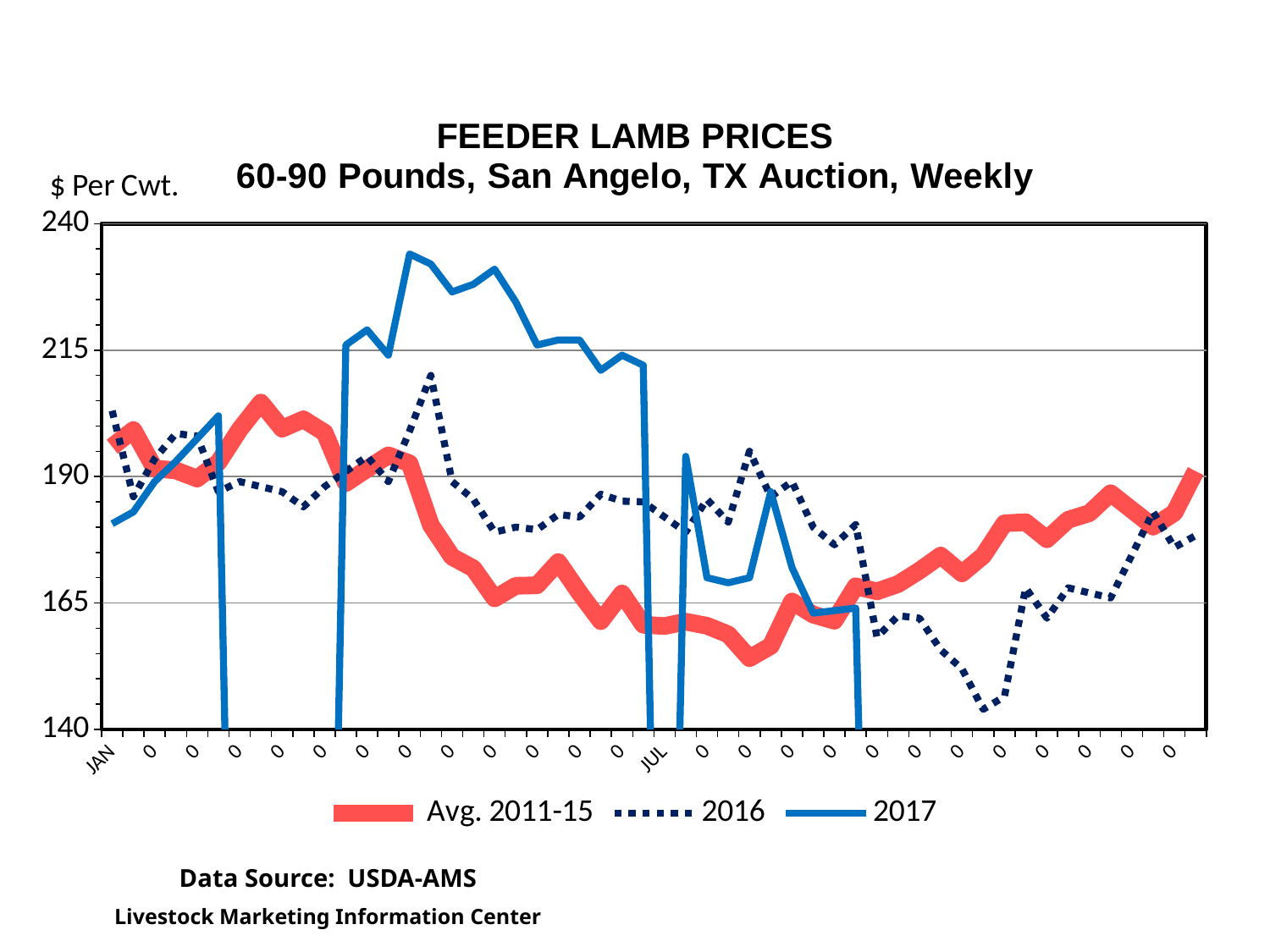
Is the highest value reached by the 2017 line greater or less than 215? greater How many series does the legend list? 3 At JUL, which is higher, the 2016 line or the Avg. 2011-15 line? 2016 Is the value of the Avg. 2011-15 line at JUL greater or less than 165? less Is the value of the Avg. 2011-15 line at JAN greater or less than 190? greater What unit is shown on the y axis of the chart? $ Per Cwt. What are the three series listed in the legend? Avg. 2011-15, 2016, 2017 What kind of chart is shown on the slide? line chart Does the Avg. 2011-15 line generally rise or fall from JAN to JUL? fall Which series reaches the highest value anywhere on the chart? 2017